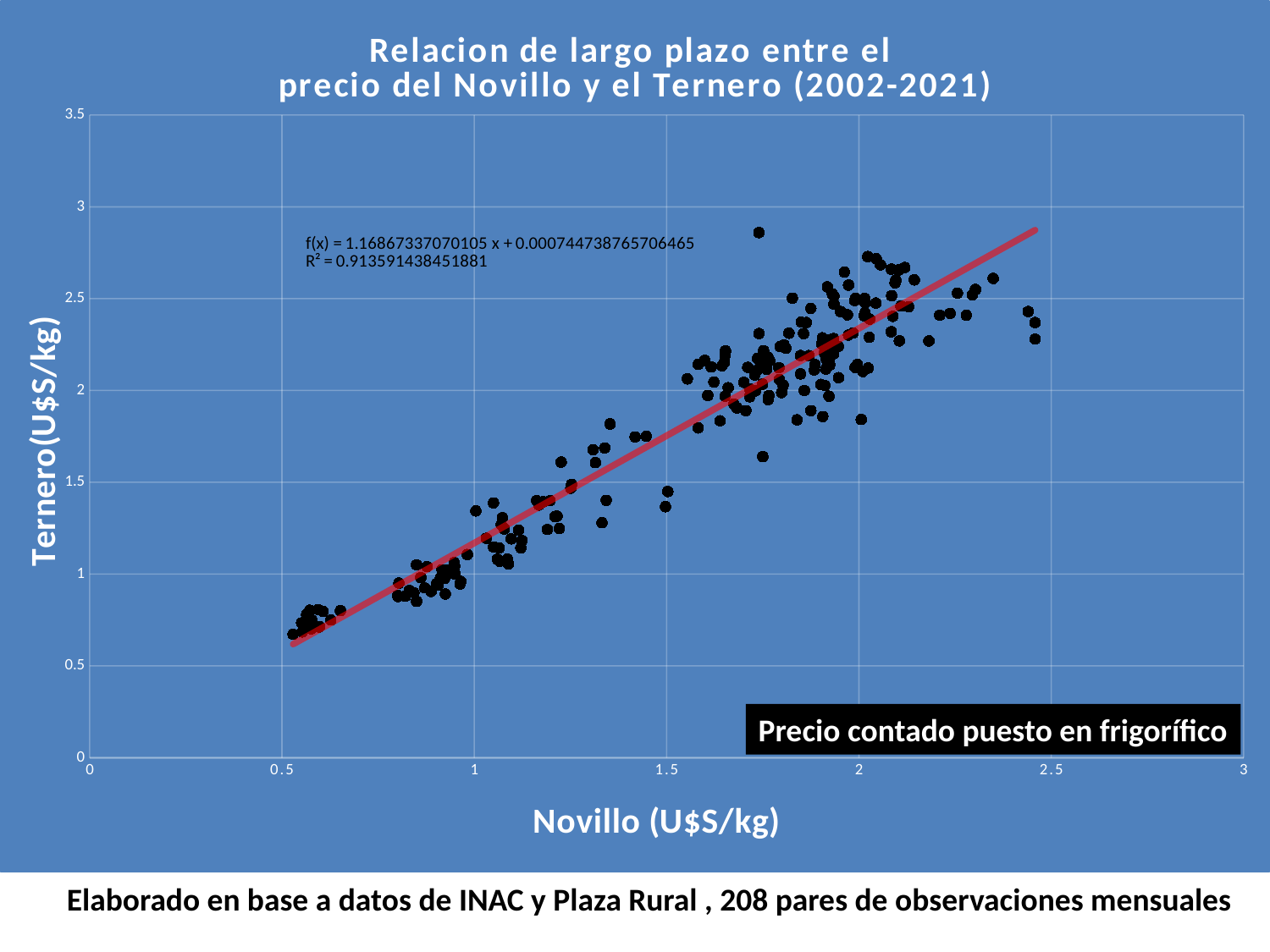
What is the label of the x axis? Novillo (U$S/kg) Is the lowest Ternero value plotted greater or less than 1? less Is the smallest Novillo value plotted greater or less than 1? less What is the title of the chart? Relacion de largo plazo entre el precio del Novillo y el Ternero (2002-2021) Is the largest Novillo value plotted greater or less than 2? greater Do the Ternero values rise or fall as the Novillo price increases along the x axis? rise How many pairs of monthly observations does the slide say the chart is based on? 208 What is the R² value printed on the chart? 0.913591438451881 What is the slope of the fitted line f(x) printed on the chart? 1.16867337070105 What is the intercept of the fitted line f(x) printed on the chart? 0.000744738765706465 What kind of chart is shown on the slide? scatter chart